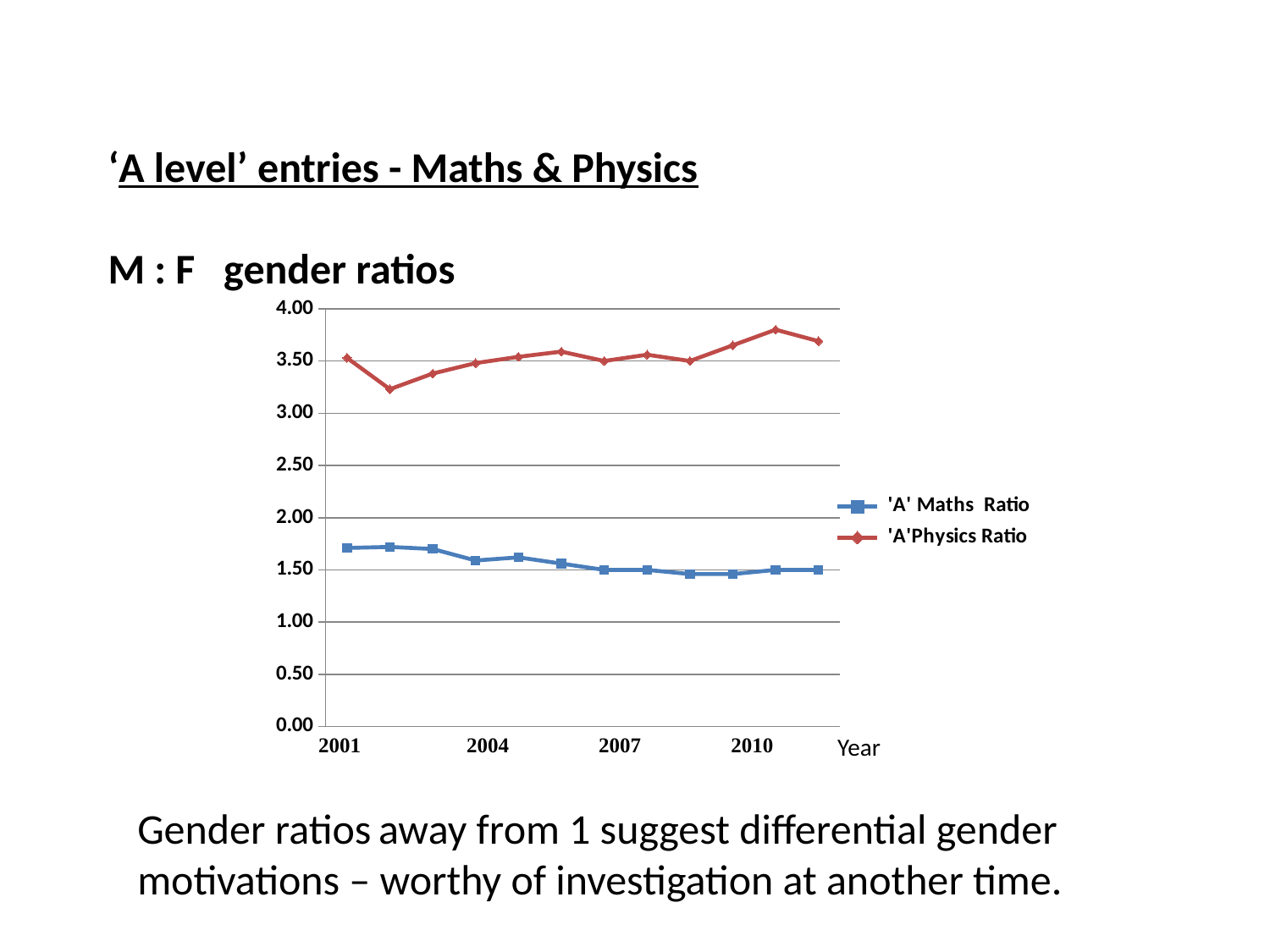
Does the 'A' Maths Ratio generally rise or fall from 2001 to 2012? fall In which year is the 'A'Physics Ratio lowest? 2002 In which year is the 'A'Physics Ratio highest? 2011 Is the 'A'Physics Ratio value for 2001 greater or less than 3.00? greater What label is shown on the x axis of the chart? Year Is the 'A' Maths Ratio value for 2001 greater or less than 1.50? greater What kind of chart is shown on the slide? line chart Is the 'A' Maths Ratio value for 2004 greater or less than 2.00? less In 2007, which series has the larger value, 'A' Maths Ratio or 'A'Physics Ratio? 'A'Physics Ratio How many series does the legend list? 2 How many data points are plotted for the 'A' Maths Ratio series? 12